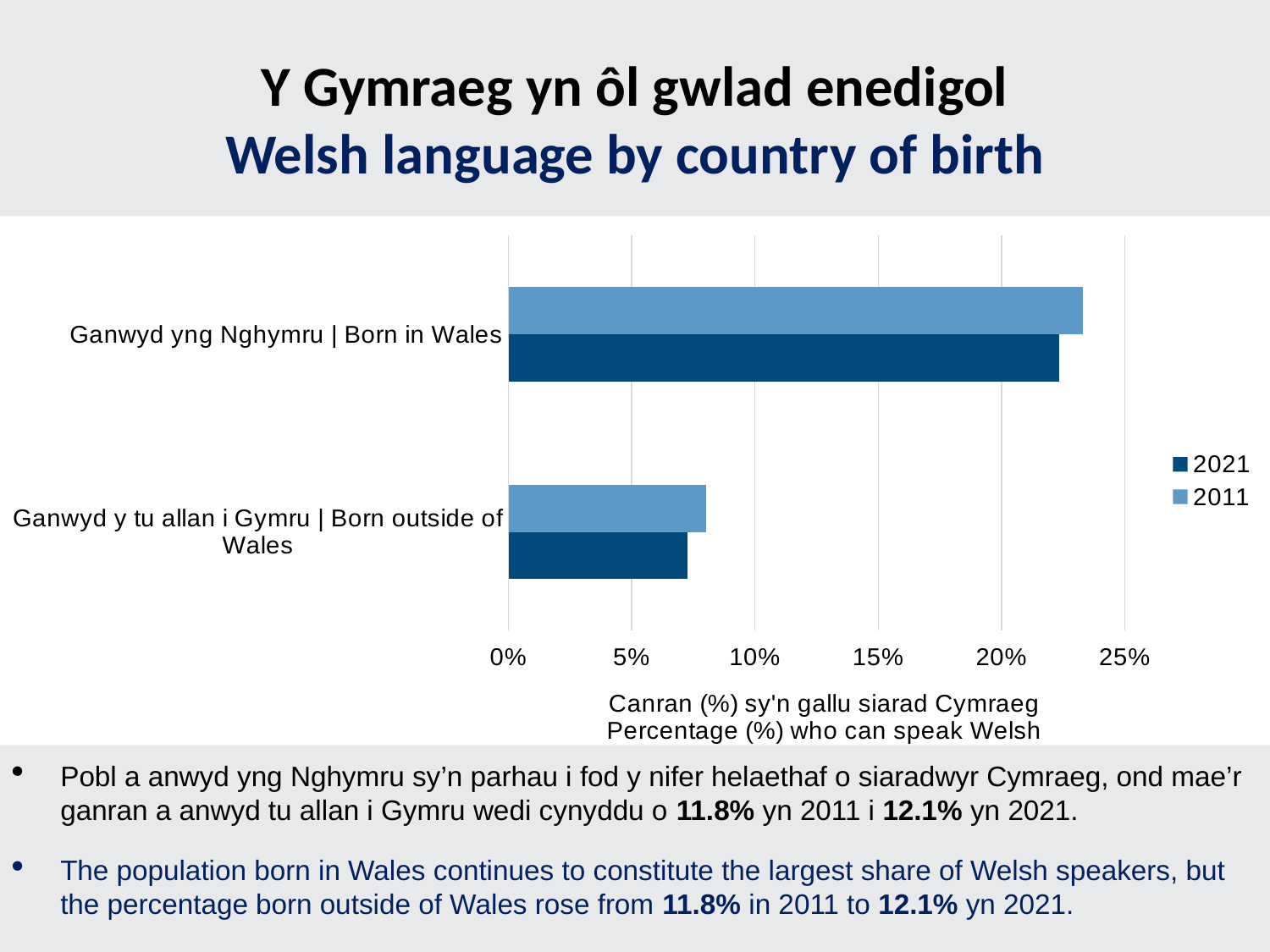
Is the 2011 value for Born in Wales greater or less than 20%? greater How many categories are shown on the chart? 2 Which years are listed in the chart's legend? 2021 and 2011 Which category has the lowest percentage who can speak Welsh? Ganwyd y tu allan i Gymru | Born outside of Wales For Born in Wales, which year has the larger value, 2011 or 2021? 2011 Is the 2011 value for Born outside of Wales greater or less than 5%? greater Is the 2021 value for Born outside of Wales greater or less than 10%? less What kind of chart is shown on the slide? bar chart Which category has the highest percentage who can speak Welsh? Ganwyd yng Nghymru | Born in Wales What is the title of the chart's horizontal axis? Canran (%) sy'n gallu siarad Cymraeg / Percentage (%) who can speak Welsh How many series does the chart's legend list? 2